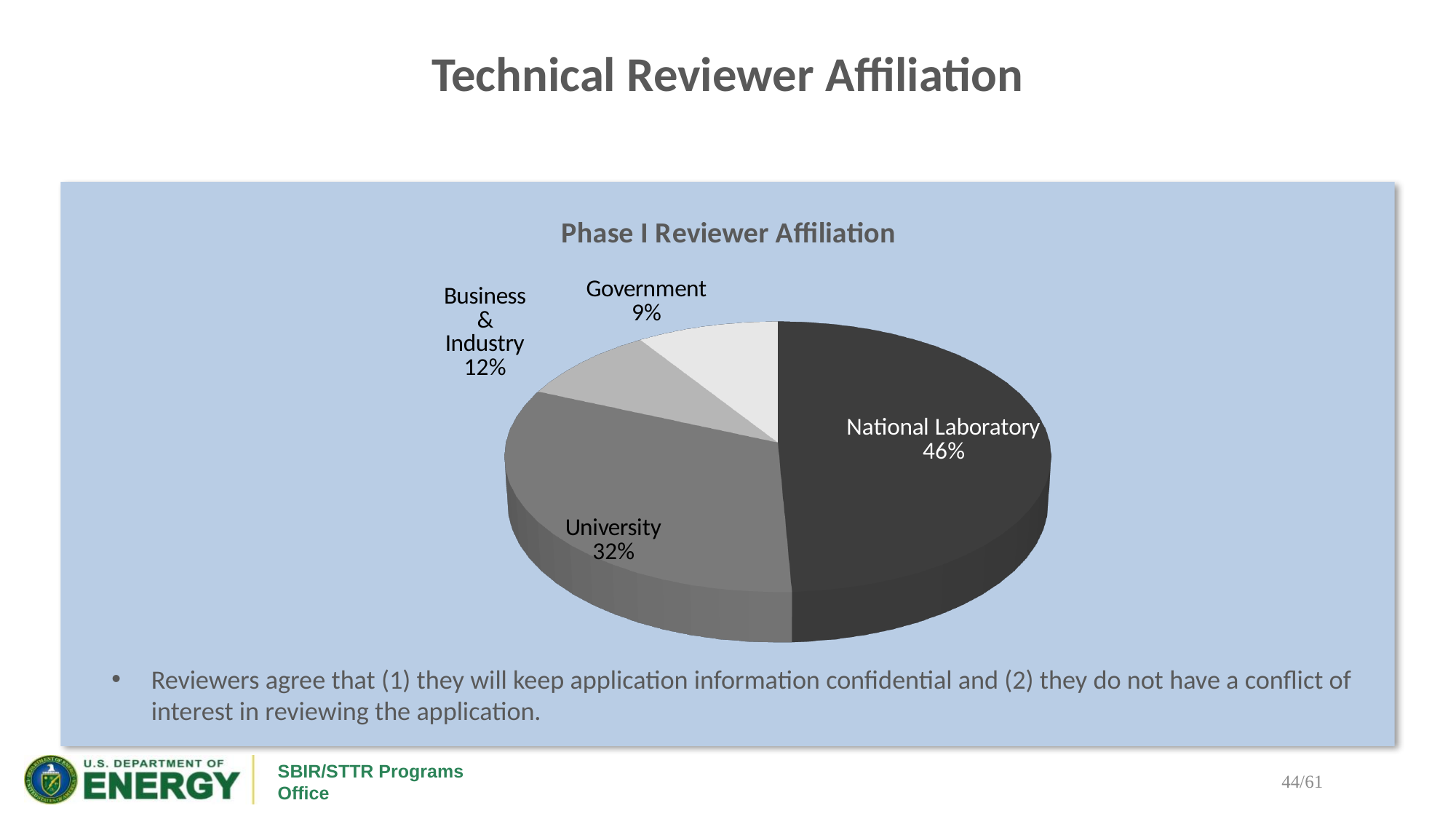
Which affiliation has the largest share of Phase I reviewers? National Laboratory How many affiliation categories does the pie chart show? 4 What is the combined share of University and Business & Industry reviewers? 44% What percentage of Phase I reviewers are from Business & Industry? 12% How many percentage points larger is the National Laboratory share than the University share? 14 What type of chart is shown on the slide? Pie chart Which is larger, the Business & Industry share or the Government share? Business & Industry What percentage of Phase I reviewers are from Government? 9% What share of Phase I reviewers are affiliated with a National Laboratory? 46% What percentage of Phase I reviewers are from a University? 32% Which affiliation has the smallest share of Phase I reviewers? Government What is the title of the chart? Phase I Reviewer Affiliation